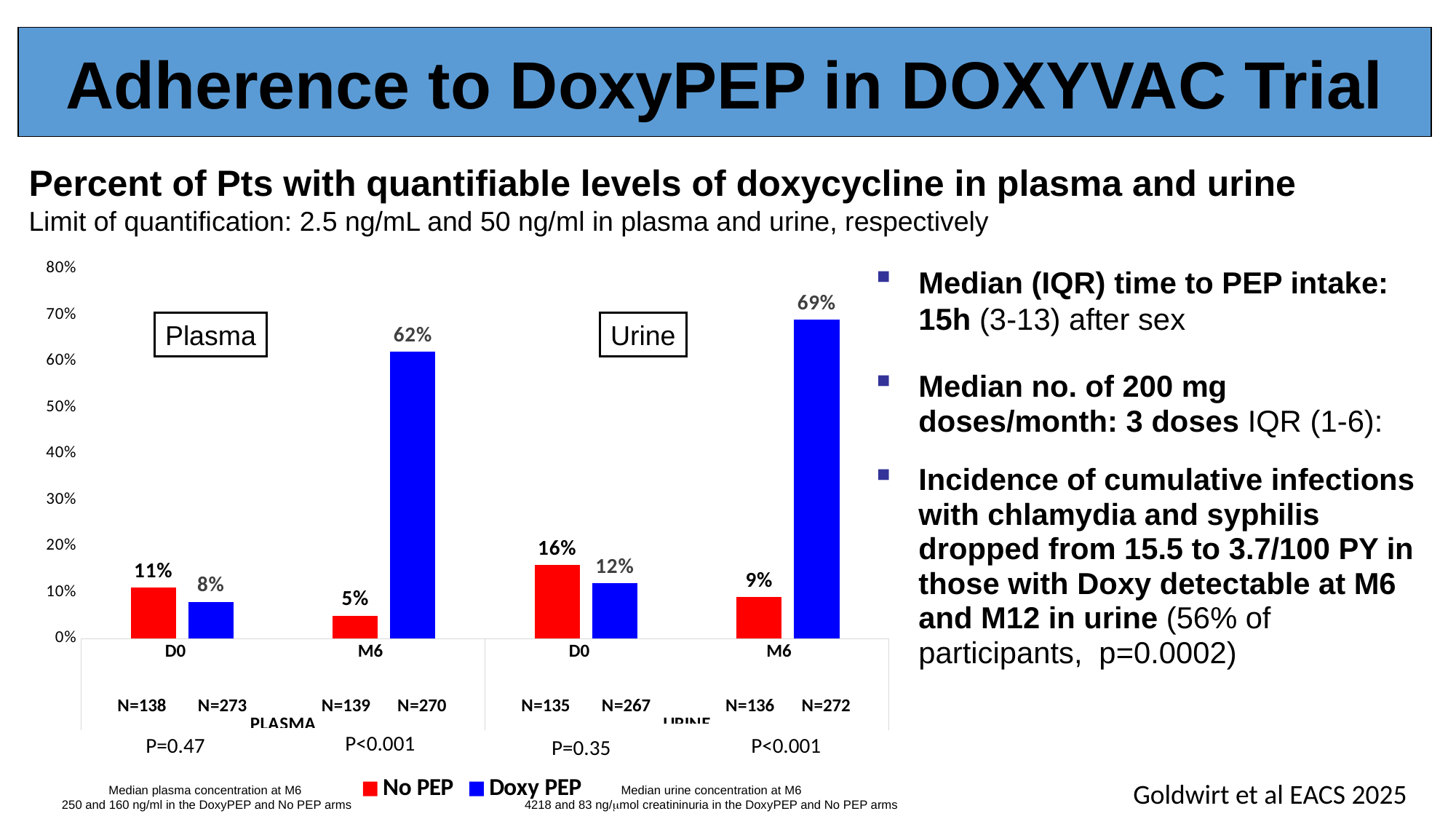
What is the value for No PEP in urine at D0? 16% Which colour represents the Doxy PEP series? Blue What kind of chart is shown on the slide? Bar chart What is the difference between the Doxy PEP values in urine and plasma at M6? 7 percentage points How many series does the legend list? 2 What is the difference between the Doxy PEP and No PEP values in plasma at M6? 57 percentage points What percentage of Doxy PEP patients had quantifiable doxycycline in plasma at M6? 62% What percentage of Doxy PEP patients had quantifiable doxycycline in urine at M6? 69% Which bar in the chart has the highest value? Doxy PEP, Urine M6 (69%) At D0 in urine, which is larger: No PEP or Doxy PEP? No PEP Which bar in the chart has the lowest value? No PEP, Plasma M6 (5%) What is the value for No PEP in plasma at D0? 11%